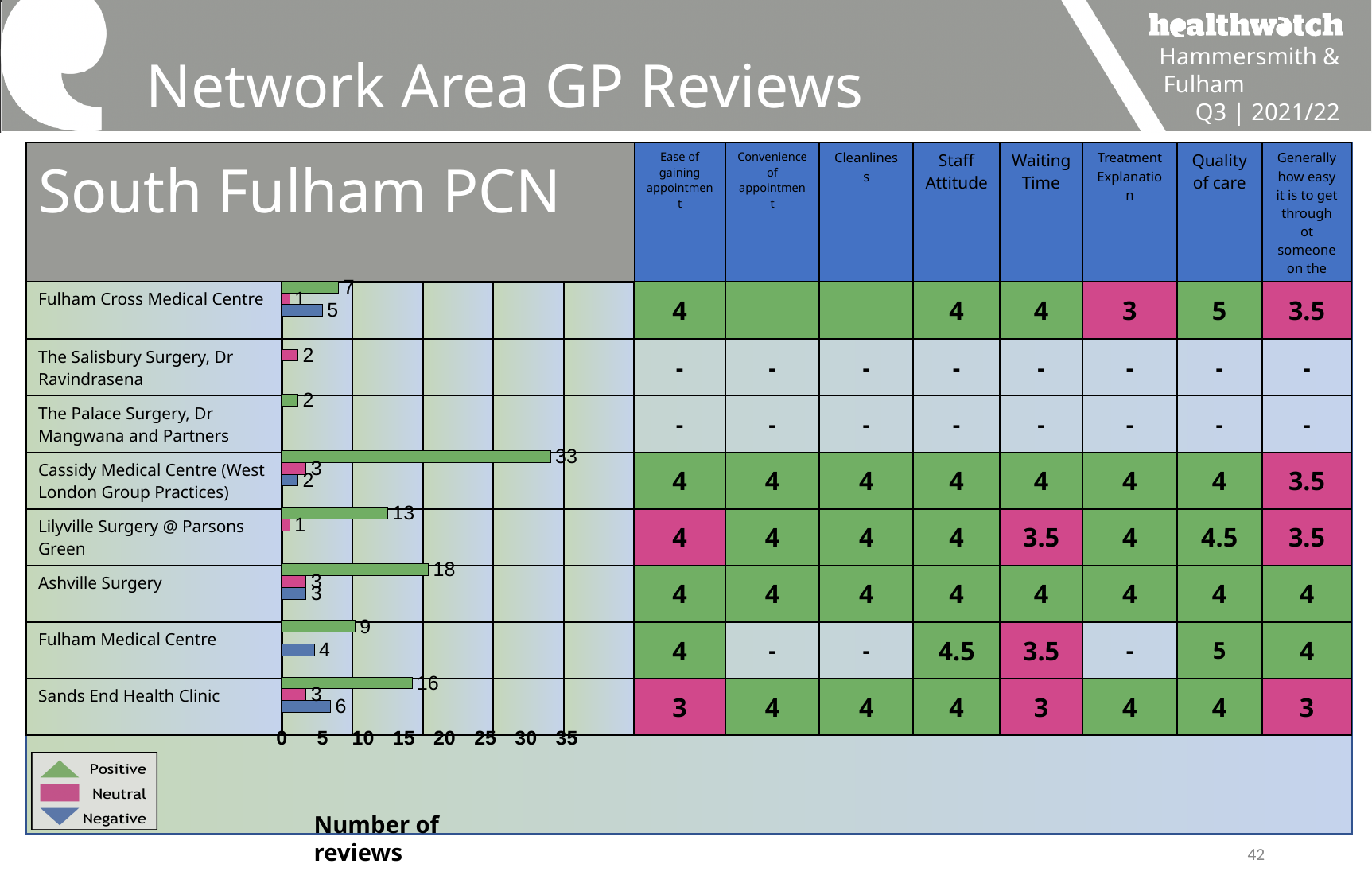
What type of chart is used to show the number of reviews? Bar chart How many positive reviews does Ashville Surgery have in the bar chart? 18 What is the difference between the positive reviews for Ashville Surgery and Lilyville Surgery @ Parsons Green? 5 How many series does the legend of the bar chart list? 3 How many practices are listed in the bar chart? 8 Is the number of positive reviews for Cassidy Medical Centre greater or less than 30? greater What is the total number of reviews (positive, neutral and negative) for Fulham Cross Medical Centre? 13 Which practice has the highest number of positive reviews in the bar chart? Cassidy Medical Centre (West London Group Practices) How many negative reviews does Sands End Health Clinic have in the bar chart? 6 Which practice has the highest number of negative reviews in the bar chart? Sands End Health Clinic Which has more positive reviews, Sands End Health Clinic or Fulham Medical Centre? Sands End Health Clinic How many positive reviews does Cassidy Medical Centre (West London Group Practices) have in the bar chart? 33